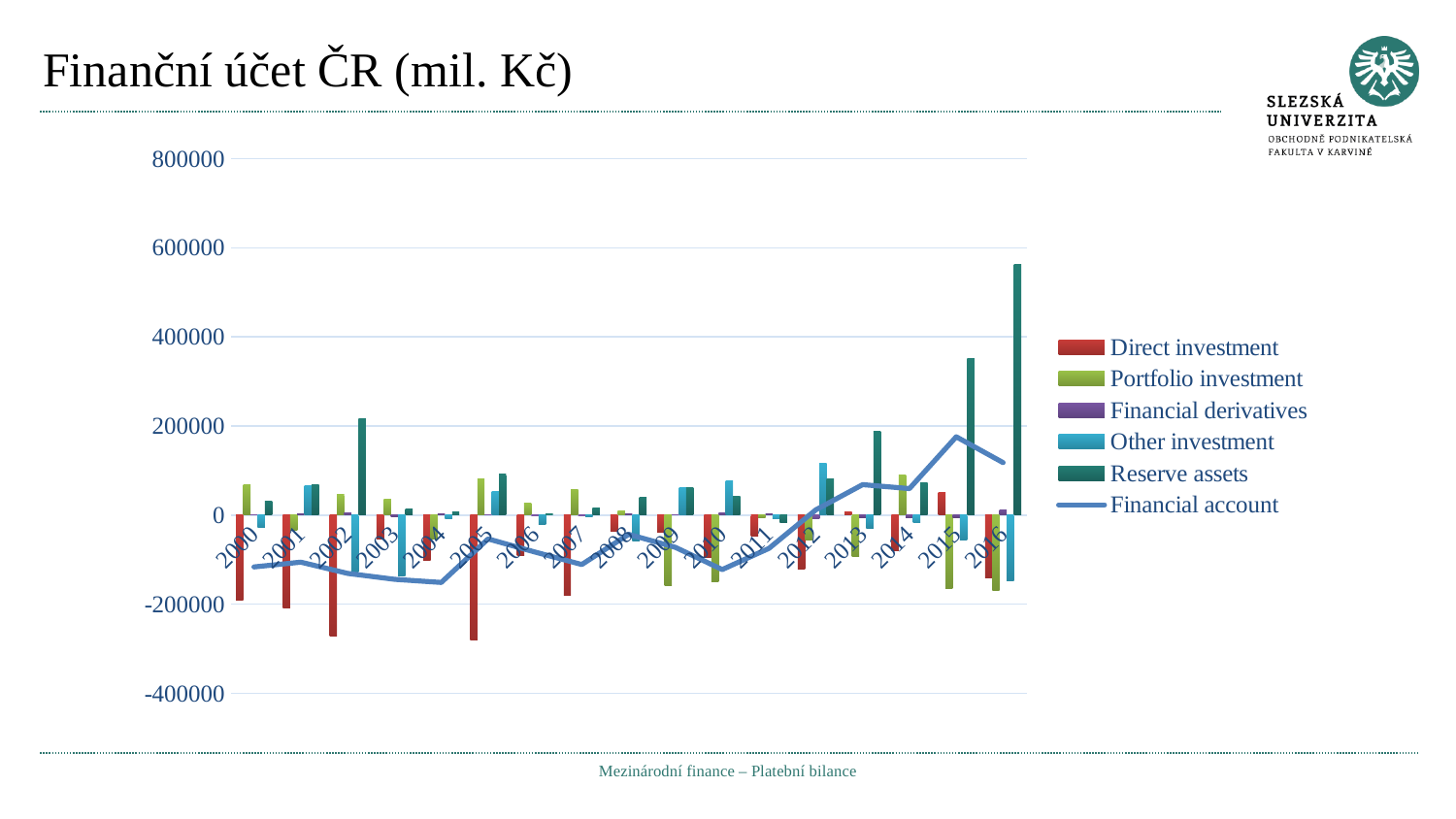
Is the value for Reserve assets in 2015 greater or less than 200000? greater What kind of chart is this? Bar chart with a line series Is the Financial account value in 2004 greater or less than 0? less Which series is drawn as a line rather than bars? Financial account What is the title of the chart? Finanční účet ČR (mil. Kč) Does the Financial account line rise or fall from 2012 to 2015? rise Is the value for Reserve assets in 2016 greater or less than 400000? greater In which year is the Reserve assets bar the highest? 2016 Which is larger, Reserve assets in 2016 or Reserve assets in 2015? Reserve assets in 2016 How many series does the legend list? 6 How many years are shown on the x axis? 17